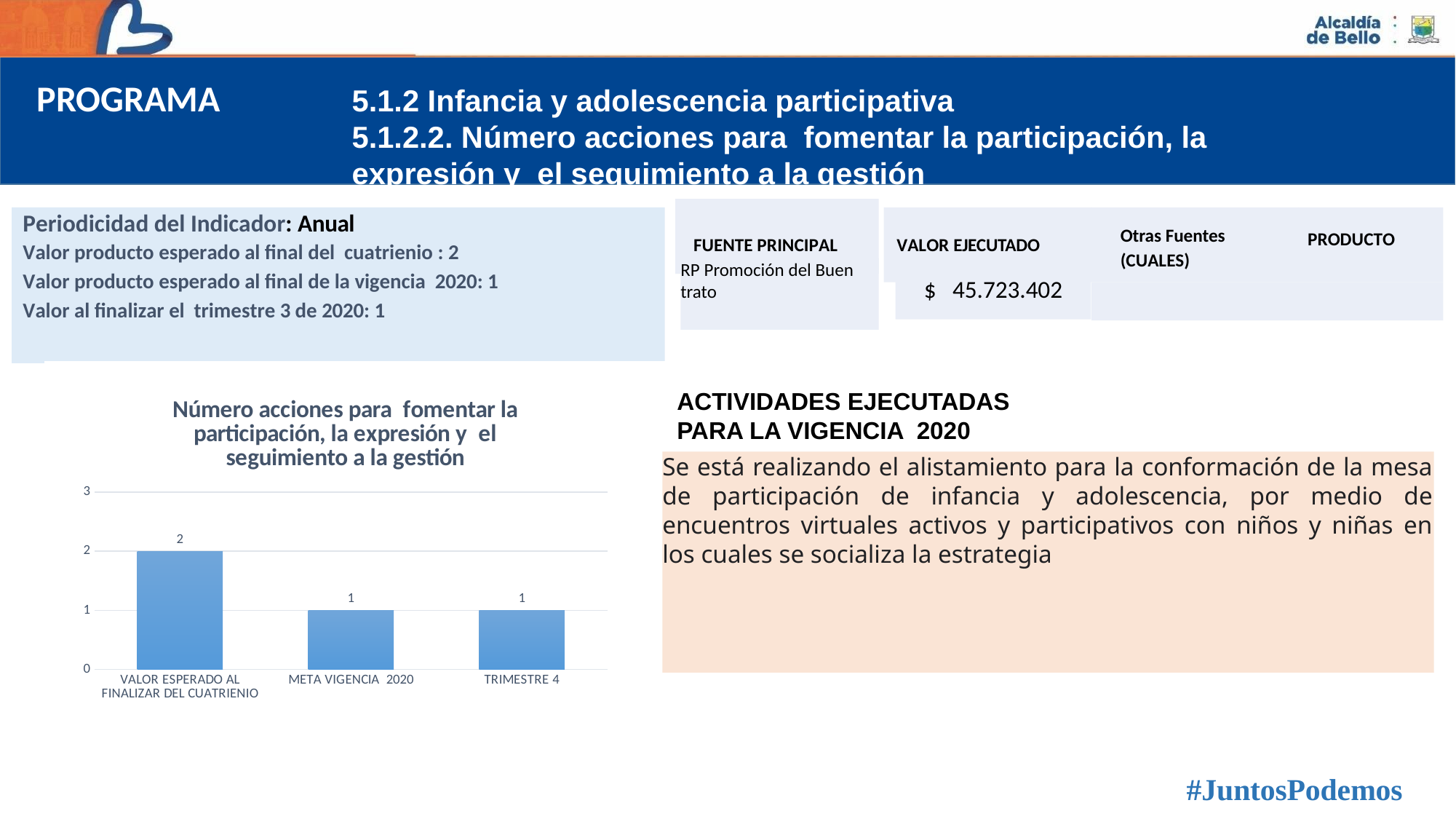
What is the highest value shown on the vertical axis of the chart? 3 What is the title of the chart? Número acciones para fomentar la participación, la expresión y el seguimiento a la gestión What is the value for META VIGENCIA 2020? 1 What kind of chart is shown on the slide? bar chart What is the value for VALOR ESPERADO AL FINALIZAR DEL CUATRIENIO? 2 Which category has the highest value? VALOR ESPERADO AL FINALIZAR DEL CUATRIENIO Is the value for VALOR ESPERADO AL FINALIZAR DEL CUATRIENIO greater or less than 3? less How many categories are shown on the chart? 3 What is the difference between the value for VALOR ESPERADO AL FINALIZAR DEL CUATRIENIO and the value for META VIGENCIA 2020? 1 Which is larger, the value for VALOR ESPERADO AL FINALIZAR DEL CUATRIENIO or the value for TRIMESTRE 4? VALOR ESPERADO AL FINALIZAR DEL CUATRIENIO What is the value for TRIMESTRE 4? 1